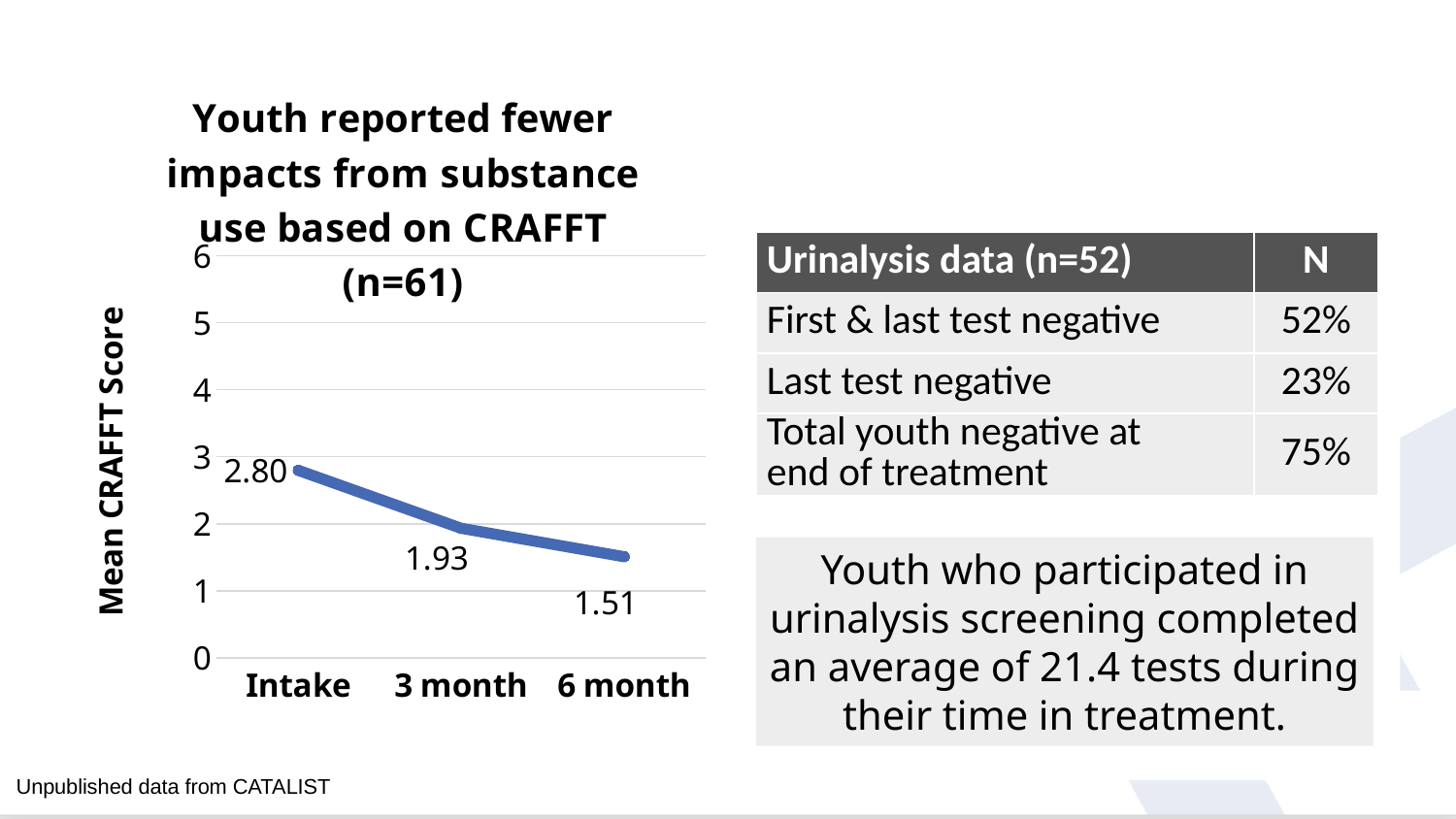
What is the mean CRAFFT score at Intake? 2.80 What is the mean CRAFFT score at 6 month? 1.51 Is the mean CRAFFT score at Intake greater or less than 3? less Do the mean CRAFFT scores rise or fall from Intake to 6 month? fall At which time point is the mean CRAFFT score lowest? 6 month At which time point is the mean CRAFFT score highest? Intake Which is larger, the mean CRAFFT score at 3 month or at 6 month? 3 month How many time points are plotted on the chart? 3 What is the difference between the mean CRAFFT score at Intake and at 3 month? 0.87 What kind of chart is shown on the slide? line chart What is the mean CRAFFT score at 3 month? 1.93 What is the difference between the mean CRAFFT score at Intake and at 6 month? 1.29